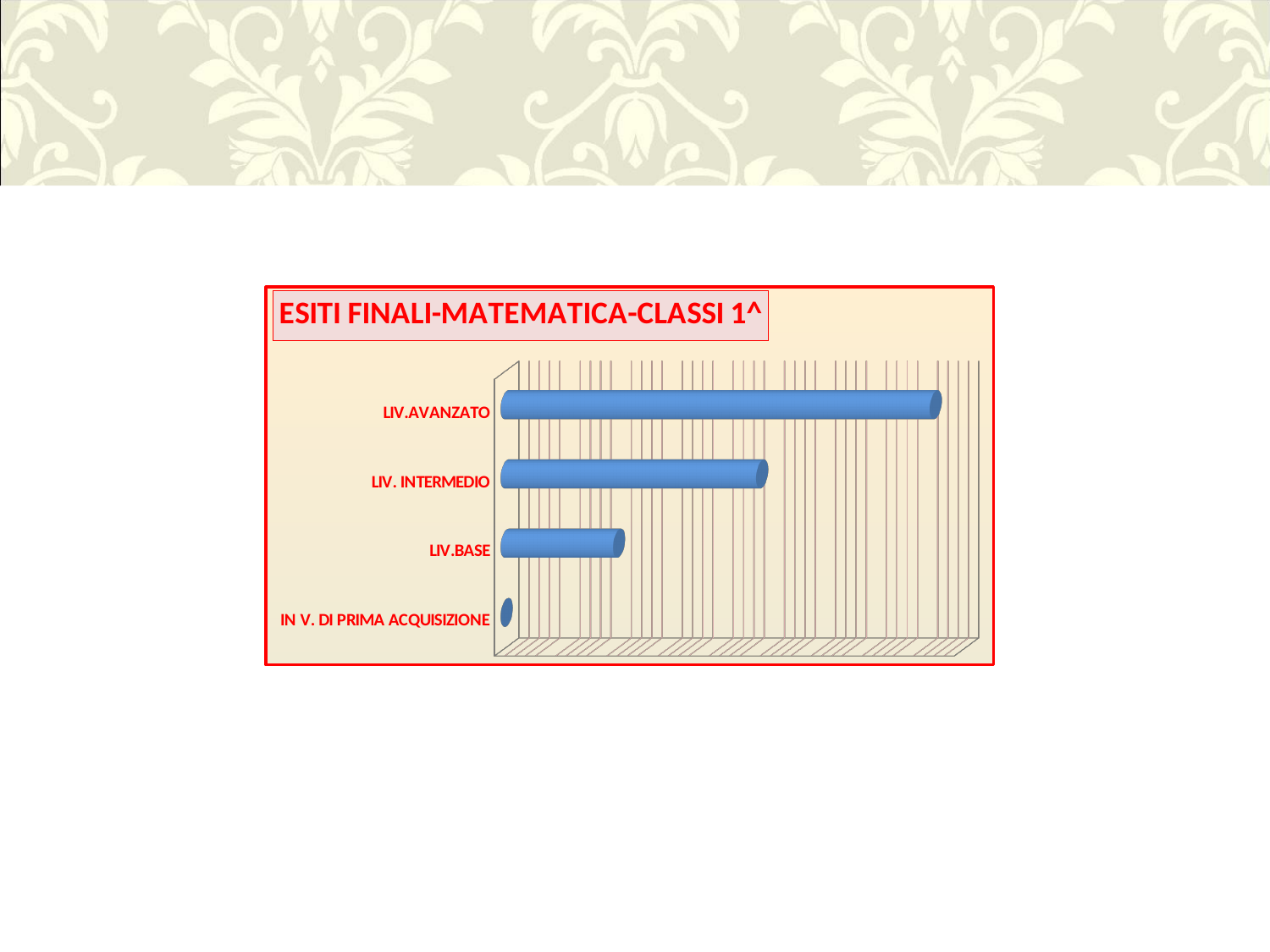
How many categories are shown in the chart? 4 What kind of chart is shown on the slide? Bar chart Which is larger, the value for LIV.BASE or the value for IN V. DI PRIMA ACQUISIZIONE? LIV.BASE Are the bars in the chart horizontal or vertical? Horizontal Which is larger, the value for LIV.AVANZATO or the value for LIV. INTERMEDIO? LIV.AVANZATO Which category has the highest value? LIV.AVANZATO Which category is listed at the top of the chart? LIV.AVANZATO Which is larger, the value for LIV. INTERMEDIO or the value for LIV.BASE? LIV. INTERMEDIO What is the title of the chart? ESITI FINALI-MATEMATICA-CLASSI 1^ Which category has the lowest value? IN V. DI PRIMA ACQUISIZIONE